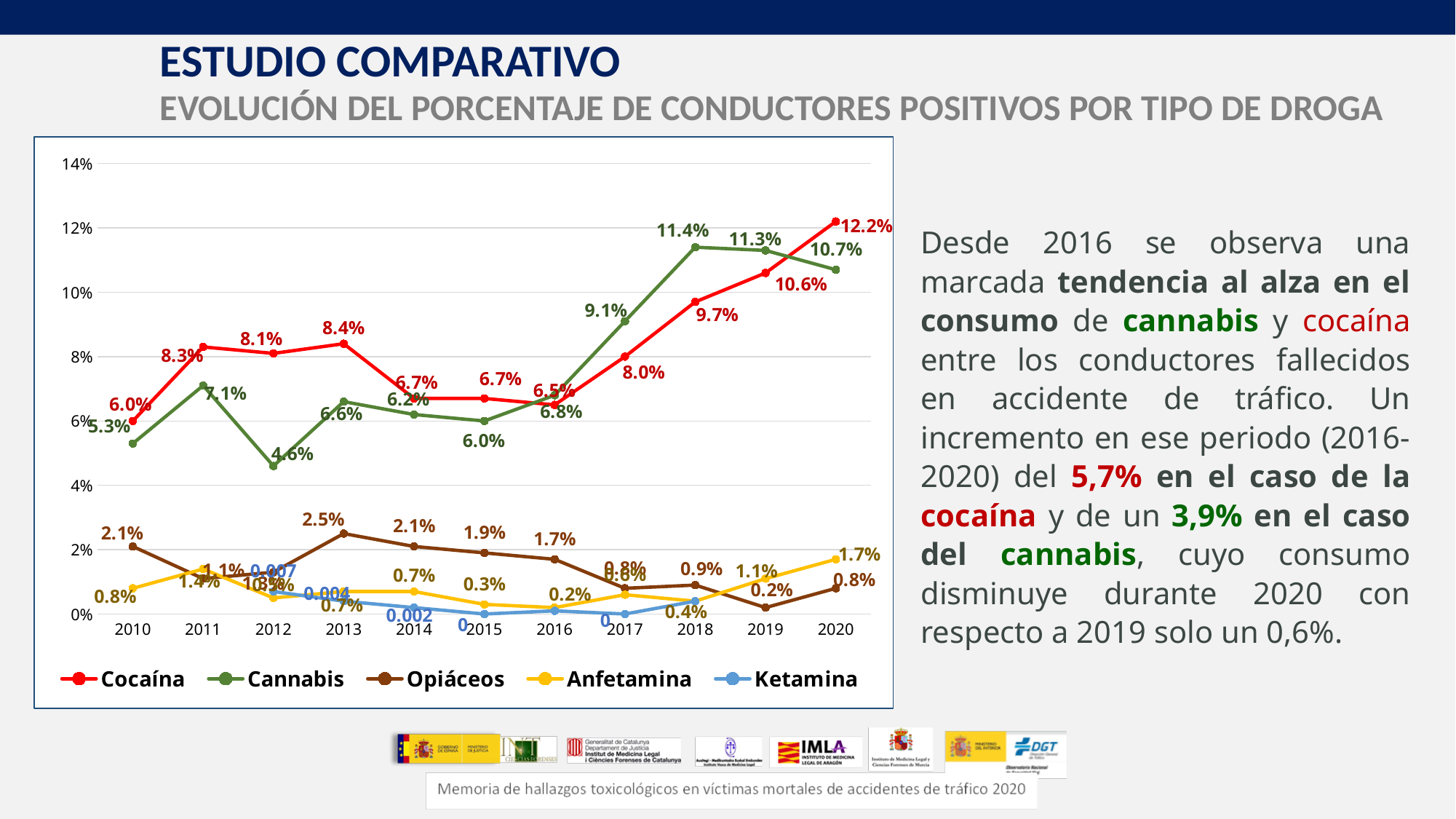
Does the Cocaína line rise or fall from 2016 to 2020? rise What type of chart is shown on the slide? line chart How many years are shown on the x axis of the chart? 11 What is the value for Cannabis in 2018? 11.4% What is the difference between the Cocaína value in 2020 and in 2016? 5.7% Which is larger in 2020, the value for Cocaína or the value for Cannabis? Cocaína What is the value for Opiáceos in 2013? 2.5% What is the value for Anfetamina in 2020? 1.7% In which year does Cannabis have its lowest value? 2012 How many series does the chart legend list? 5 In which year does Cocaína reach its highest value? 2020 What is the value for Cocaína in 2020? 12.2%